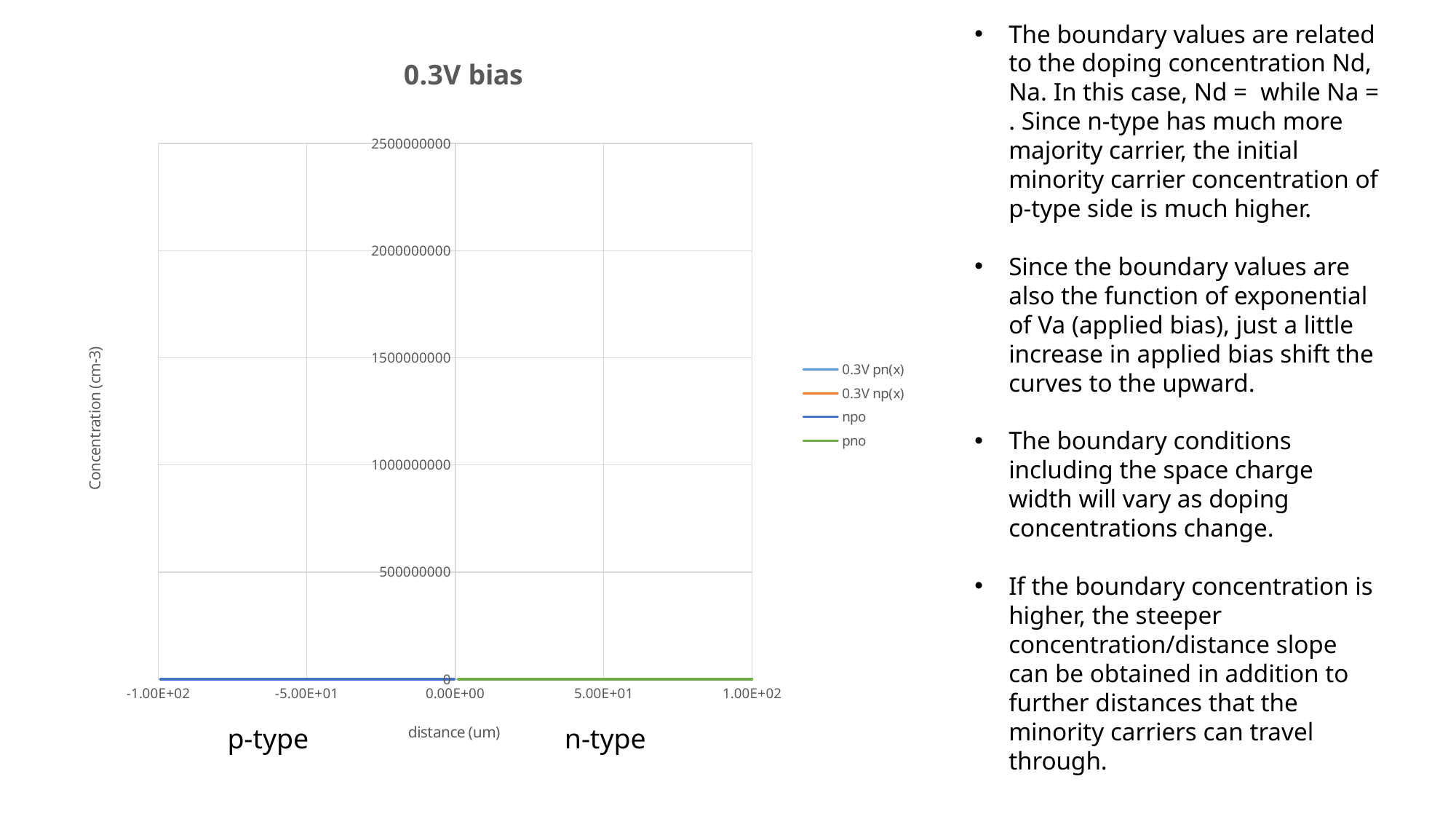
Is the value of the pno series at distance 1.00E+02 greater or less than 1000000000? less What kind of chart is shown on the slide? line chart What is the label of the vertical axis of the chart? Concentration (cm-3) Is the value of the npo series at distance 0.00E+00 greater or less than 500000000? less How many tick labels are shown on the horizontal (distance) axis of the chart? 5 Is the value of the 0.3V pn(x) series at distance 5.00E+01 greater or less than 500000000? less How many series does the legend of the chart list? 4 What is the title of the chart? 0.3V bias